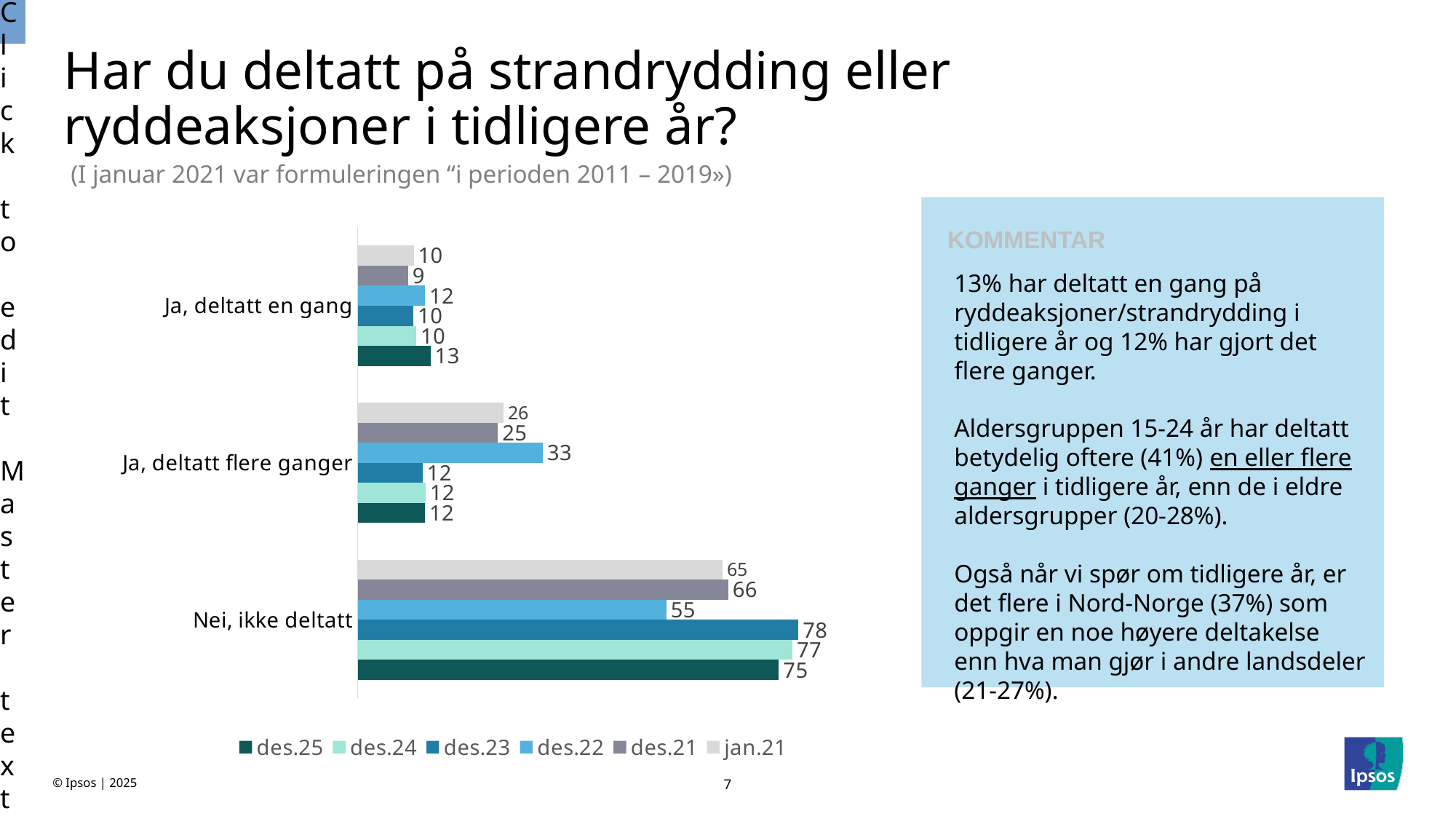
What is the value for des.22 in the category "Ja, deltatt flere ganger"? 33 What is the difference between the des.25 and des.24 values in the category "Nei, ikke deltatt"? 2 How many series does the legend list? 6 What is the value for des.25 in the category "Ja, deltatt en gang"? 13 Which series has the highest value in the category "Nei, ikke deltatt"? des.23 What is the difference between the des.22 and des.23 values in the category "Ja, deltatt flere ganger"? 21 Which is larger in the category "Nei, ikke deltatt": the value for jan.21 or the value for des.22? jan.21 What kind of chart is shown on the slide? Bar chart Which series has the lowest value in the category "Nei, ikke deltatt"? des.22 How many categories are shown on the chart? 3 What is the value for des.21 in the category "Ja, deltatt en gang"? 9 What is the value for des.23 in the category "Nei, ikke deltatt"? 78